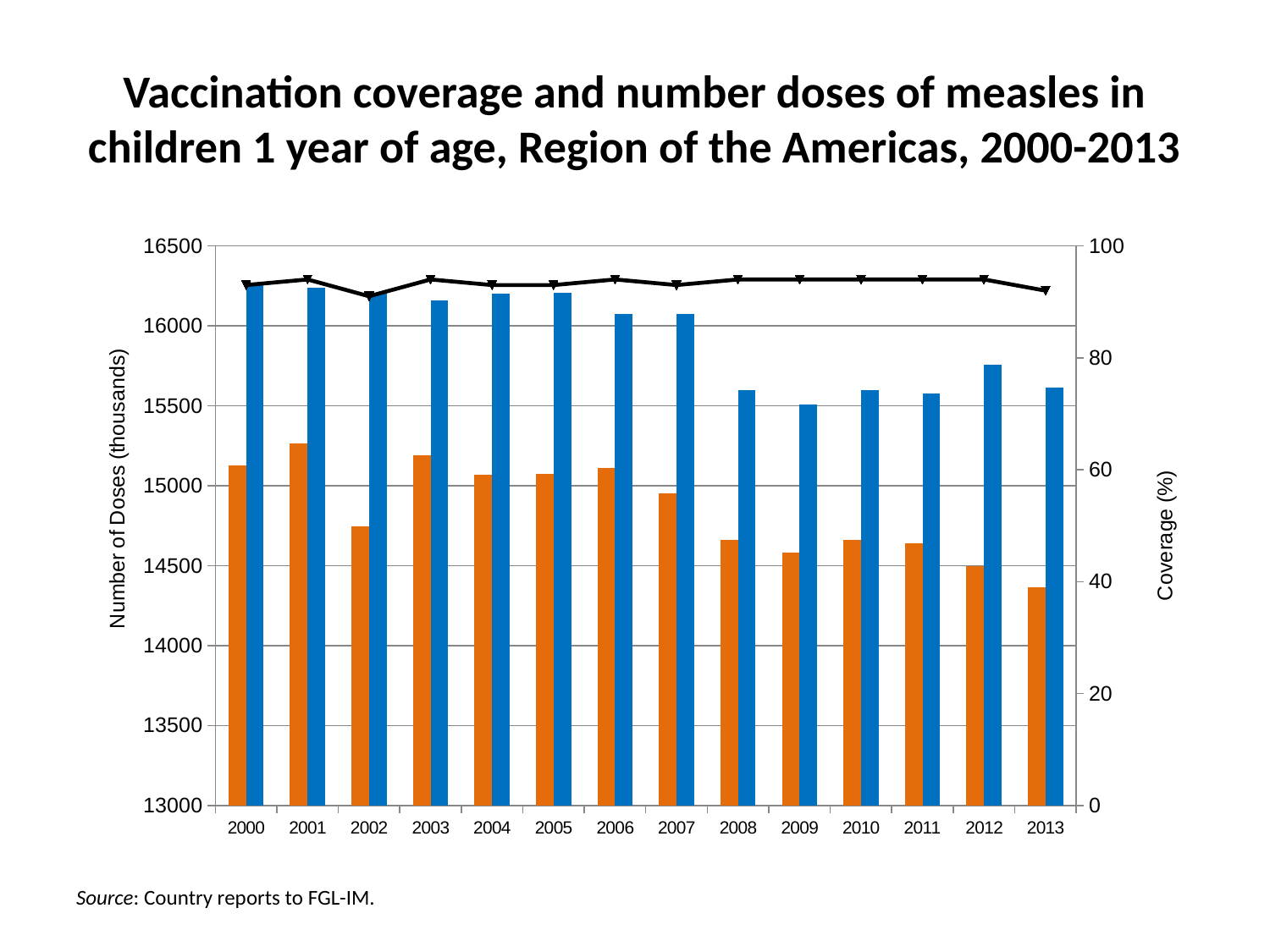
Is the orange bar for 2001 greater or less than 15000? greater Which year has the lowest orange bar? 2013 Which year has the lowest blue bar? 2009 Which year has the highest orange bar? 2001 How many years are shown on the x axis of the chart? 14 What is the title of the right-hand vertical axis? Coverage (%) Do the orange bars generally rise or fall from 2000 to 2013? fall Is the orange bar for 2013 greater or less than 14500? less Is the blue bar for 2007 greater or less than 16000? greater What kind of chart is shown on the slide? Bar chart with a line Which is larger, the orange bar for 2001 or the orange bar for 2013? 2001